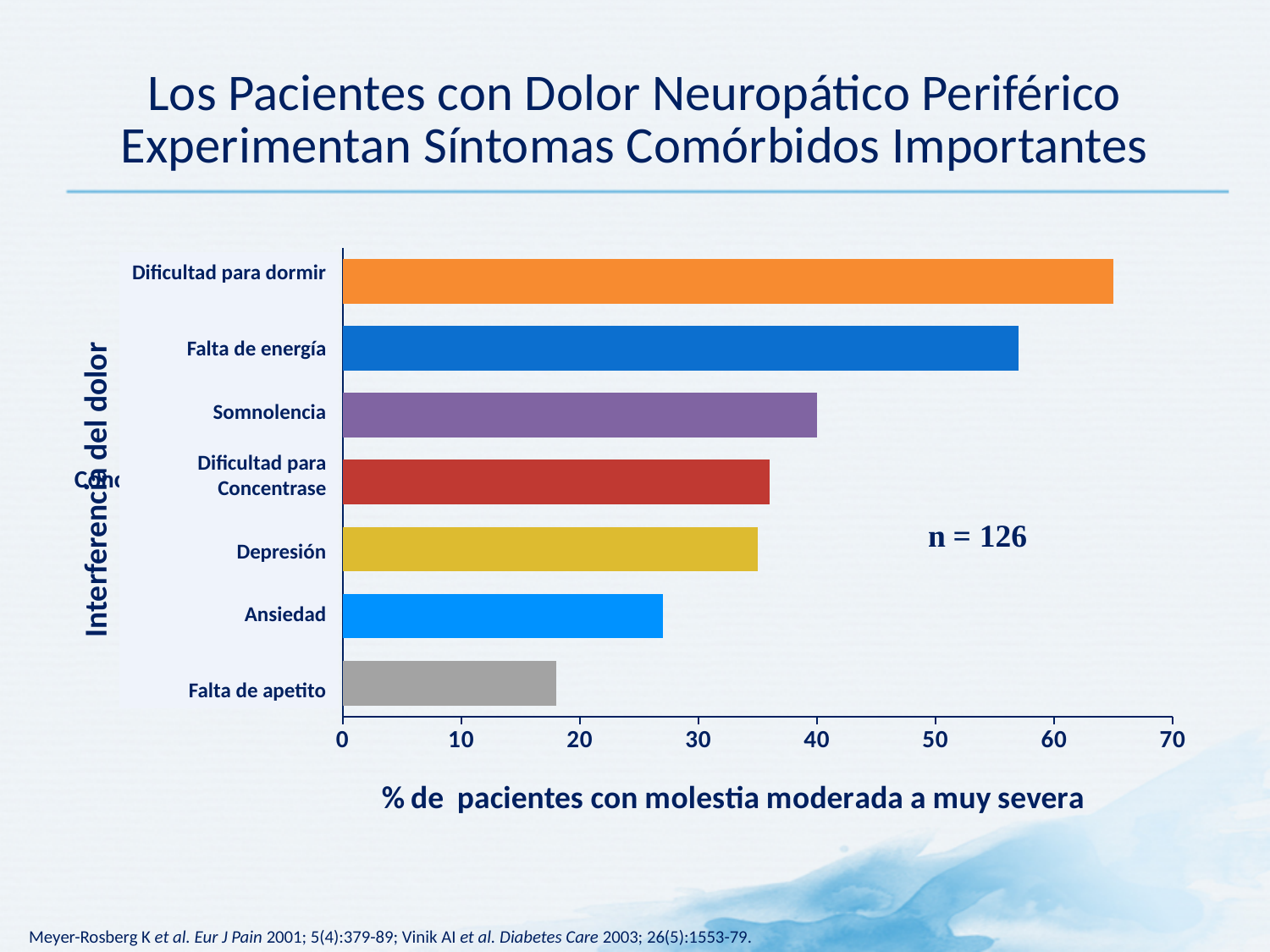
Is the value for Ansiedad greater or less than 30? less Is the value for Falta de energía greater or less than 50? greater Which is larger, the value for Ansiedad or the value for Falta de apetito? Ansiedad Is the value for Depresión greater or less than 40? less Which symptom has the lowest percentage of patients with moderate to very severe discomfort? Falta de apetito Which symptom has the highest percentage of patients with moderate to very severe discomfort? Dificultad para dormir How many symptom categories are plotted in the chart? 7 What is the label of the horizontal axis of the chart? % de pacientes con molestia moderada a muy severa Which is larger, the value for Dificultad para dormir or the value for Falta de energía? Dificultad para dormir What kind of chart is shown on the slide? bar chart